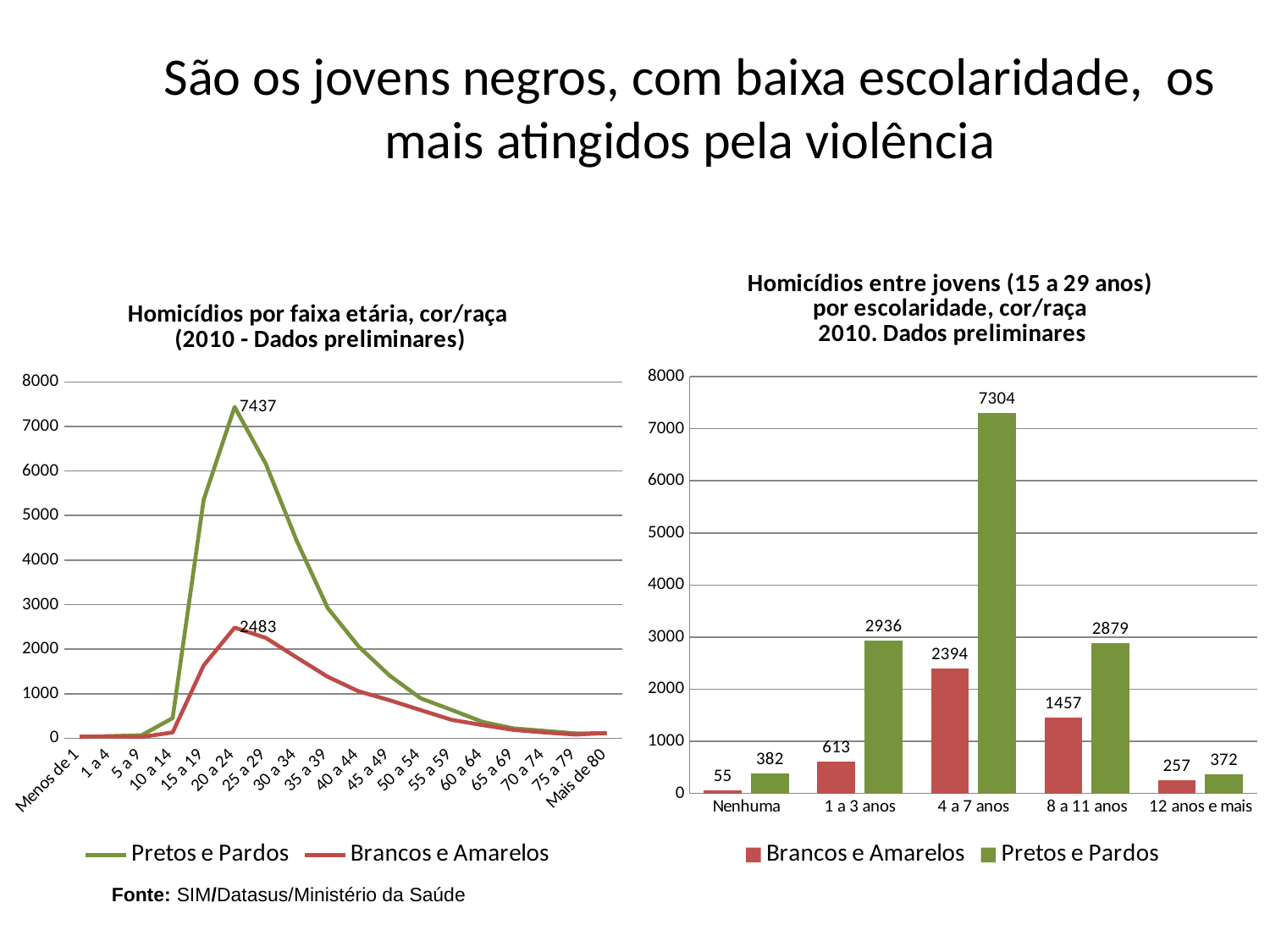
In the right chart (Homicídios entre jovens por escolaridade), which education category has the lowest value for Brancos e Amarelos? Nenhuma In the right chart (Homicídios entre jovens por escolaridade), what is the value for Pretos e Pardos in the '4 a 7 anos' category? 7304 In the right chart (Homicídios entre jovens por escolaridade), what is the difference between Pretos e Pardos and Brancos e Amarelos in the '8 a 11 anos' category? 1422 In the right chart (Homicídios entre jovens por escolaridade), how many education categories are shown on the x axis? 5 In the right chart (Homicídios entre jovens por escolaridade), what type of chart is used? Bar chart In the right chart (Homicídios entre jovens por escolaridade), which education category has the highest value for Pretos e Pardos? 4 a 7 anos In the right chart (Homicídios entre jovens por escolaridade), what is the value for Brancos e Amarelos in the 'Nenhuma' category? 55 In the left chart (Homicídios por faixa etária), is the value for Pretos e Pardos in the '15 a 19' age group greater or less than 4000? greater In the left chart (Homicídios por faixa etária), what is the peak value labelled for the Pretos e Pardos series? 7437 In the left chart (Homicídios por faixa etária), what is the peak value labelled for the Brancos e Amarelos series? 2483 In the left chart (Homicídios por faixa etária), how many series does the legend list? 2 In the right chart (Homicídios entre jovens por escolaridade), which is larger in the '12 anos e mais' category: Brancos e Amarelos or Pretos e Pardos? Pretos e Pardos